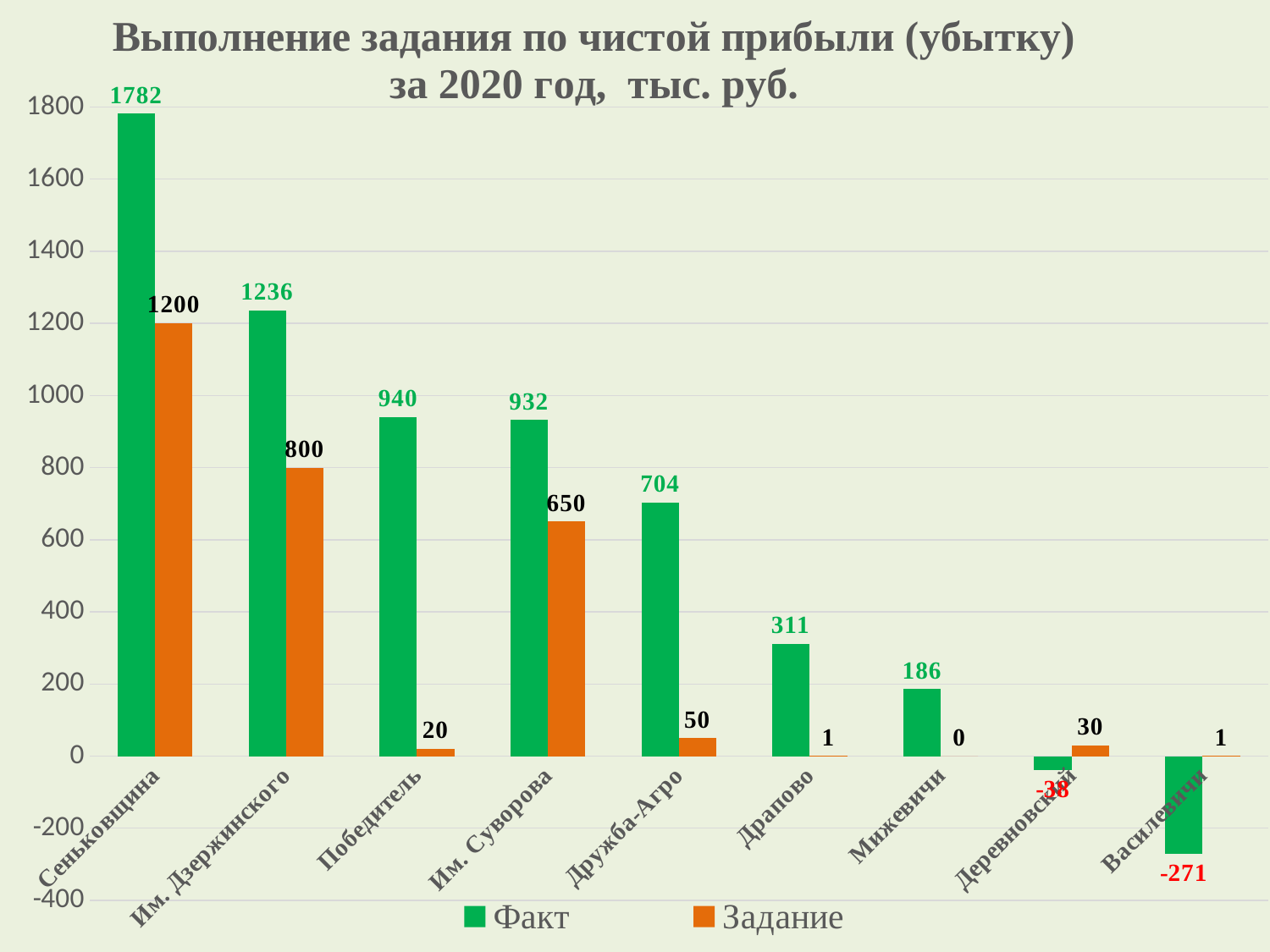
How many series does the legend list? 2 Which category has the highest Факт value? Сеньковщина What is the Задание value for Им. Суворова? 650 Which is larger for Победитель: the Факт value or the Задание value? Факт What is the Факт value for Сеньковщина? 1782 Which colour represents the Задание series? Orange What kind of chart is shown on the slide? Bar chart What is the difference between the Факт and Задание values for Дружба-Агро? 654 Which category has the lowest Факт value? Василевичи How many categories are shown on the x axis? 9 What is the Задание value for Им. Дзержинского? 800 What is the Факт value for Василевичи? -271